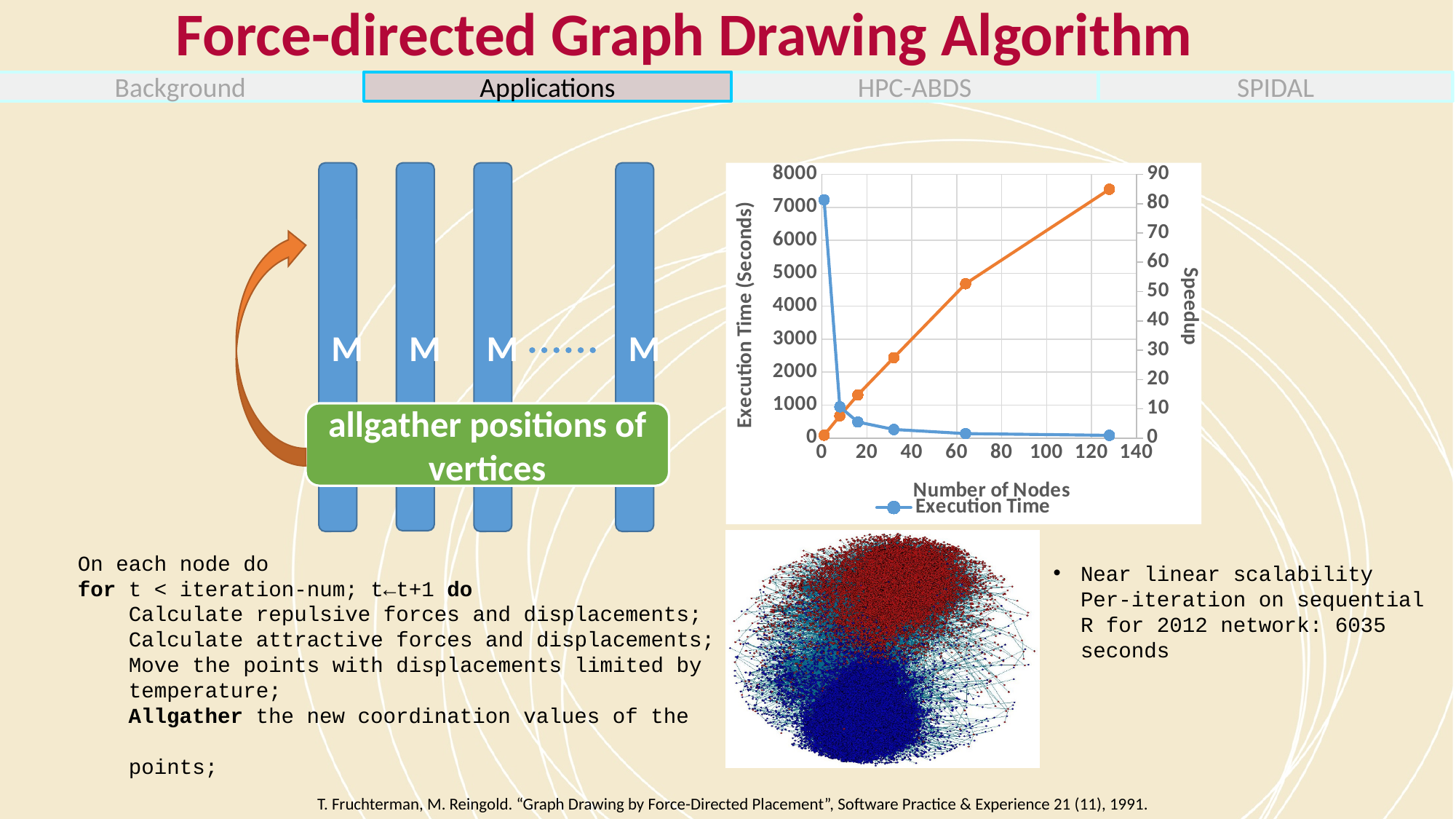
At which Number of Nodes is the Speedup highest? 128 How many data points does the Execution Time series have? 6 Is the Execution Time at 128 nodes greater or less than 1000 seconds? less At which Number of Nodes is the Execution Time highest? 1 How does the Speedup change as the Number of Nodes increases? rises Which is larger, the Execution Time at 8 nodes or at 16 nodes? 8 nodes Is the Speedup at 32 nodes greater or less than 20? greater How does the Execution Time change as the Number of Nodes increases? falls Is the Speedup at 128 nodes greater or less than 70? greater What kind of chart is shown on the slide? line chart